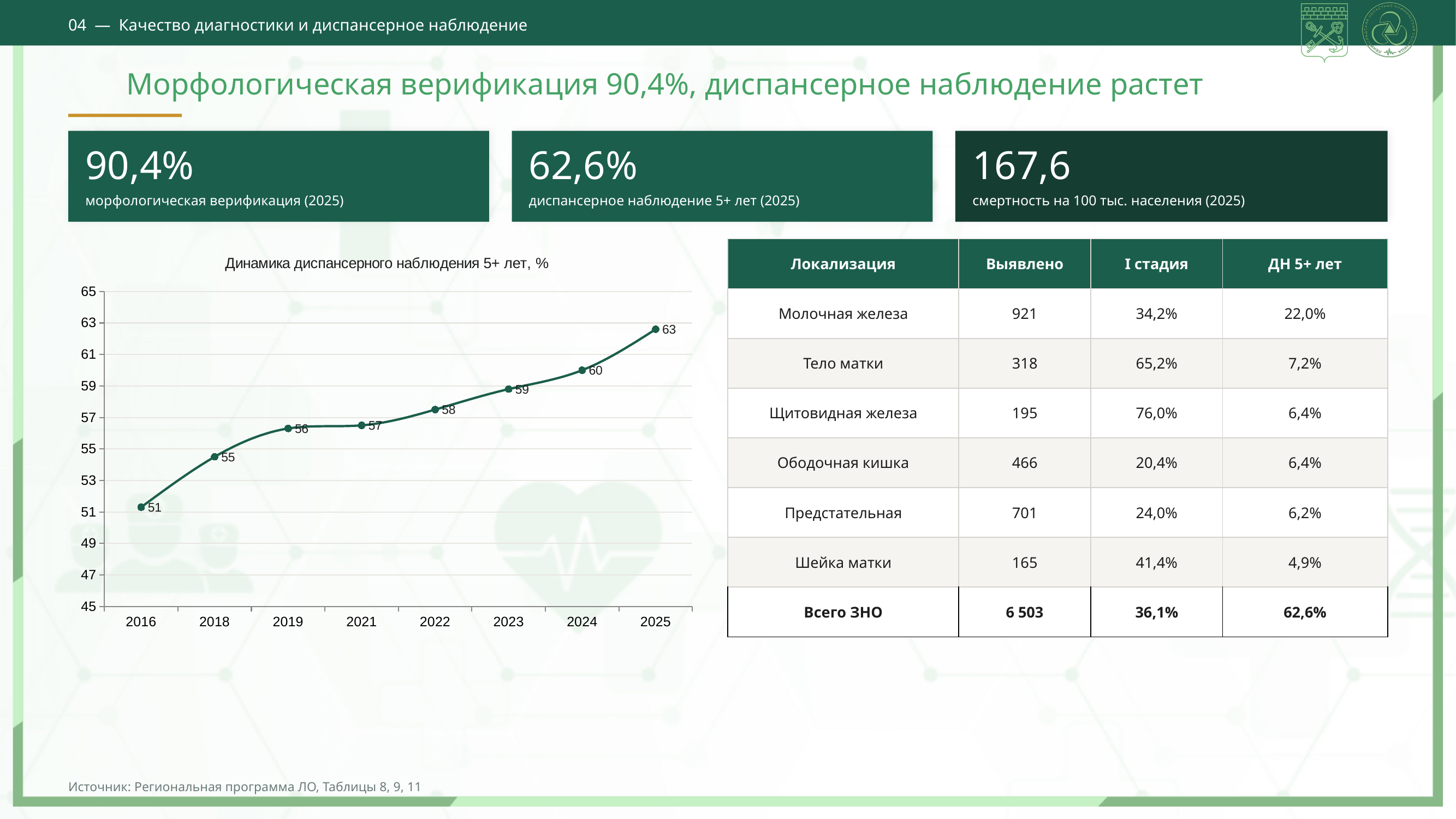
In the chart "Динамика диспансерного наблюдения 5+ лет, %", which is larger, the value for 2018 or the value for 2023? 2023 What type of chart is "Динамика диспансерного наблюдения 5+ лет, %"? line chart In the chart "Динамика диспансерного наблюдения 5+ лет, %", what is the difference between the labelled values for 2025 and 2016? 12 In the chart "Динамика диспансерного наблюдения 5+ лет, %", do the values rise or fall from 2016 to 2025? rise What is the title of the line chart on the slide? Динамика диспансерного наблюдения 5+ лет, % In the chart "Динамика диспансерного наблюдения 5+ лет, %", what is the data label for 2025? 63 In the chart "Динамика диспансерного наблюдения 5+ лет, %", which year has the lowest value? 2016 How many years are plotted on the x axis of the chart "Динамика диспансерного наблюдения 5+ лет, %"? 8 In the chart "Динамика диспансерного наблюдения 5+ лет, %", is the value for 2024 greater or less than 55? greater In the chart "Динамика диспансерного наблюдения 5+ лет, %", what is the data label for 2016? 51 In the chart "Динамика диспансерного наблюдения 5+ лет, %", what is the data label for 2022? 58 In the chart "Динамика диспансерного наблюдения 5+ лет, %", which year has the highest value? 2025